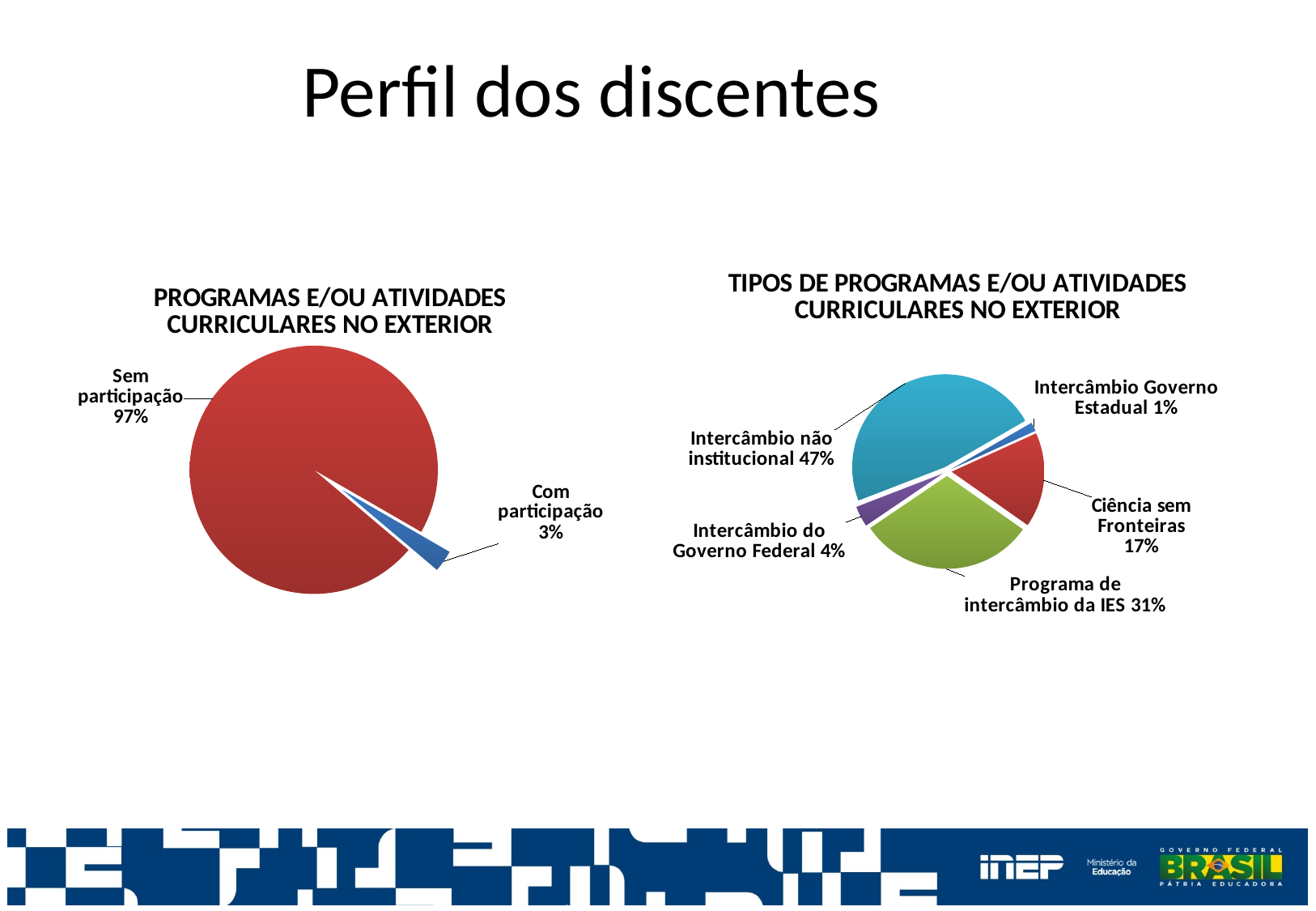
In the left chart 'PROGRAMAS E/OU ATIVIDADES CURRICULARES NO EXTERIOR', what share is labelled 'Sem participação'? 97% In the right chart 'TIPOS DE PROGRAMAS E/OU ATIVIDADES CURRICULARES NO EXTERIOR', which category has the largest share? Intercâmbio não institucional In the right chart 'TIPOS DE PROGRAMAS E/OU ATIVIDADES CURRICULARES NO EXTERIOR', which category has the smallest share? Intercâmbio Governo Estadual In the left chart 'PROGRAMAS E/OU ATIVIDADES CURRICULARES NO EXTERIOR', how many slices does the pie have? 2 In the right chart 'TIPOS DE PROGRAMAS E/OU ATIVIDADES CURRICULARES NO EXTERIOR', what share is 'Ciência sem Fronteiras'? 17% In the left chart 'PROGRAMAS E/OU ATIVIDADES CURRICULARES NO EXTERIOR', what is the difference between 'Sem participação' and 'Com participação'? 94% In the left chart 'PROGRAMAS E/OU ATIVIDADES CURRICULARES NO EXTERIOR', what share is labelled 'Com participação'? 3% In the right chart 'TIPOS DE PROGRAMAS E/OU ATIVIDADES CURRICULARES NO EXTERIOR', which is larger: 'Intercâmbio do Governo Federal' or 'Ciência sem Fronteiras'? Ciência sem Fronteiras In the right chart 'TIPOS DE PROGRAMAS E/OU ATIVIDADES CURRICULARES NO EXTERIOR', what share is 'Intercâmbio não institucional'? 47% In the right chart 'TIPOS DE PROGRAMAS E/OU ATIVIDADES CURRICULARES NO EXTERIOR', what share is 'Programa de intercâmbio da IES'? 31% What kind of chart is the left chart 'PROGRAMAS E/OU ATIVIDADES CURRICULARES NO EXTERIOR'? Pie chart In the right chart 'TIPOS DE PROGRAMAS E/OU ATIVIDADES CURRICULARES NO EXTERIOR', how many categories are shown? 5